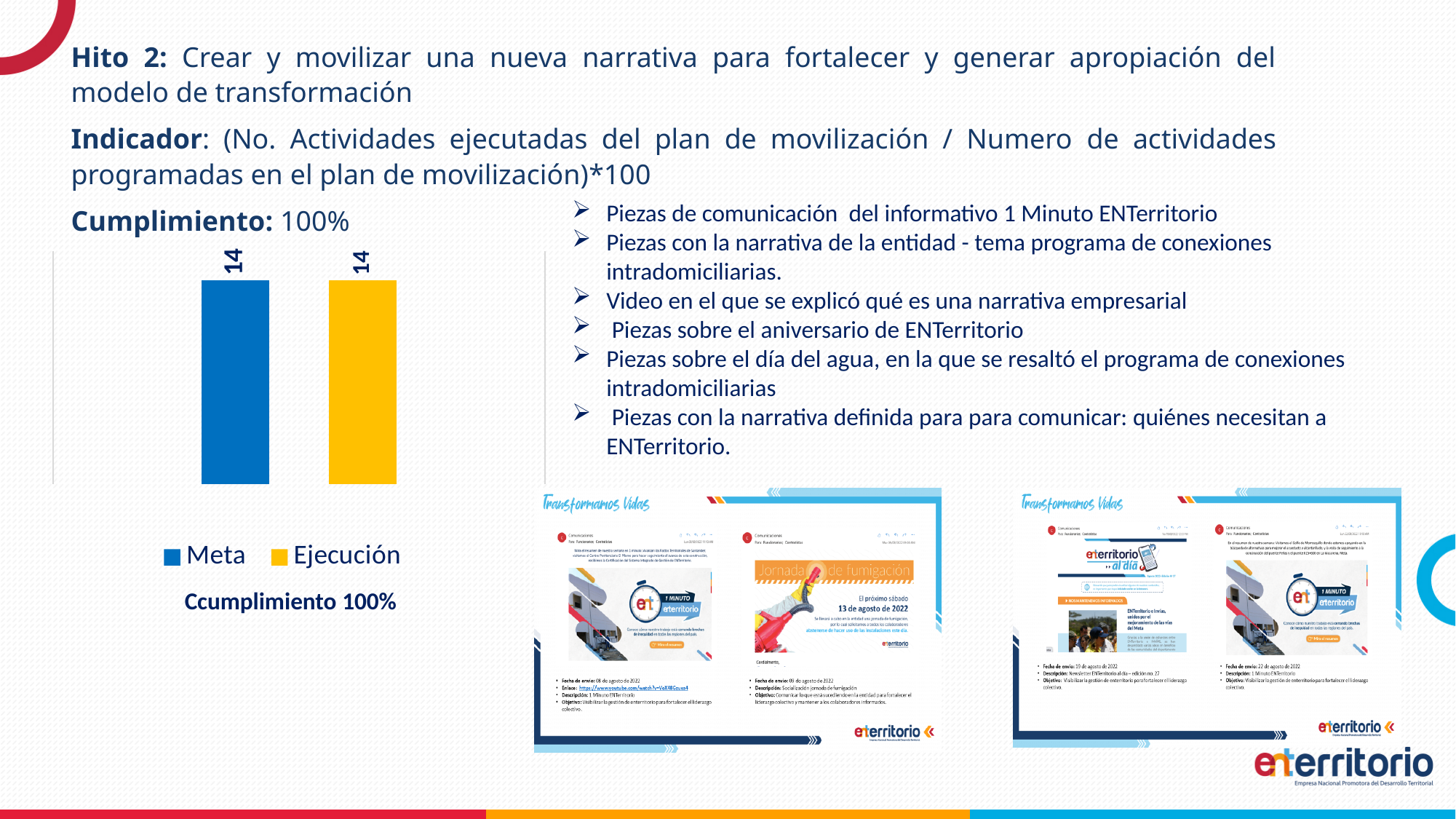
What is the total of the Meta and Ejecución values in the chart? 28 What is the difference between the Meta and Ejecución values in the chart? 0 What are the two series named in the chart legend? Meta and Ejecución How many bars are plotted in the chart? 2 What is the value of the Ejecución bar in the chart? 14 What is the value of the Meta bar in the chart? 14 Is the value for Meta in the chart greater or less than 10? greater Are the Meta and Ejecución values in the chart equal? Yes What colour is the Ejecución bar in the chart? Yellow How many series does the chart legend list? 2 Is the value for Ejecución in the chart greater or less than 20? less What kind of chart is shown on the slide? Bar chart